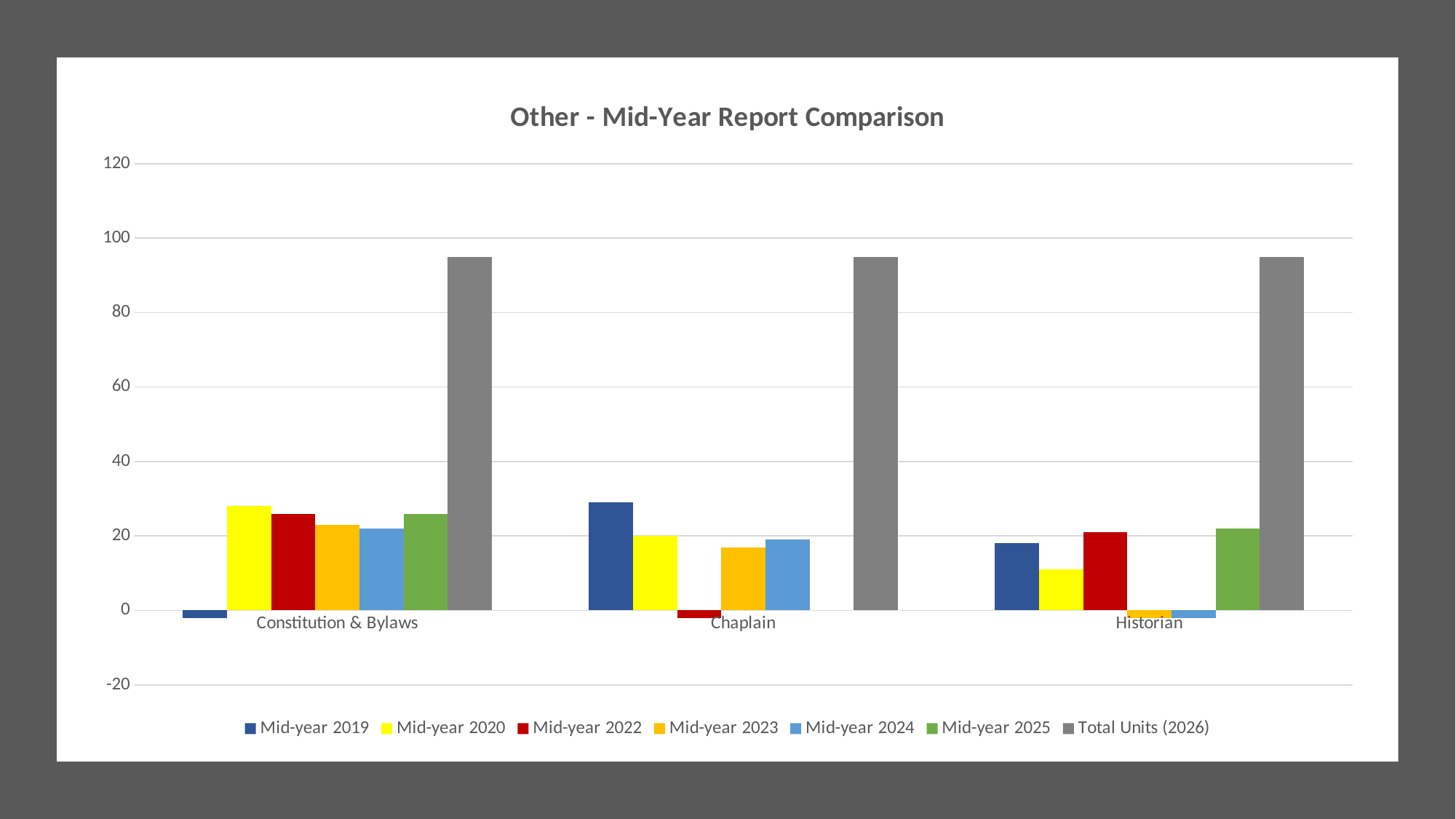
How many series does the legend list? 7 Which series has the highest value for Chaplain? Total Units (2026) What kind of chart is shown on the slide? bar chart How many categories are shown on the x axis? 3 Is the value for Mid-year 2022 for Chaplain greater or less than 0? less Is the value for Total Units (2026) for Chaplain greater or less than 100? less Which is larger, the Mid-year 2020 value for Constitution & Bylaws or the Mid-year 2020 value for Chaplain? Constitution & Bylaws Which series has the lowest value for Constitution & Bylaws? Mid-year 2019 Is the value for Mid-year 2020 for Historian greater or less than 20? less What is the title of the chart? Other - Mid-Year Report Comparison Which is larger, the Mid-year 2019 value for Chaplain or the Mid-year 2019 value for Historian? Chaplain